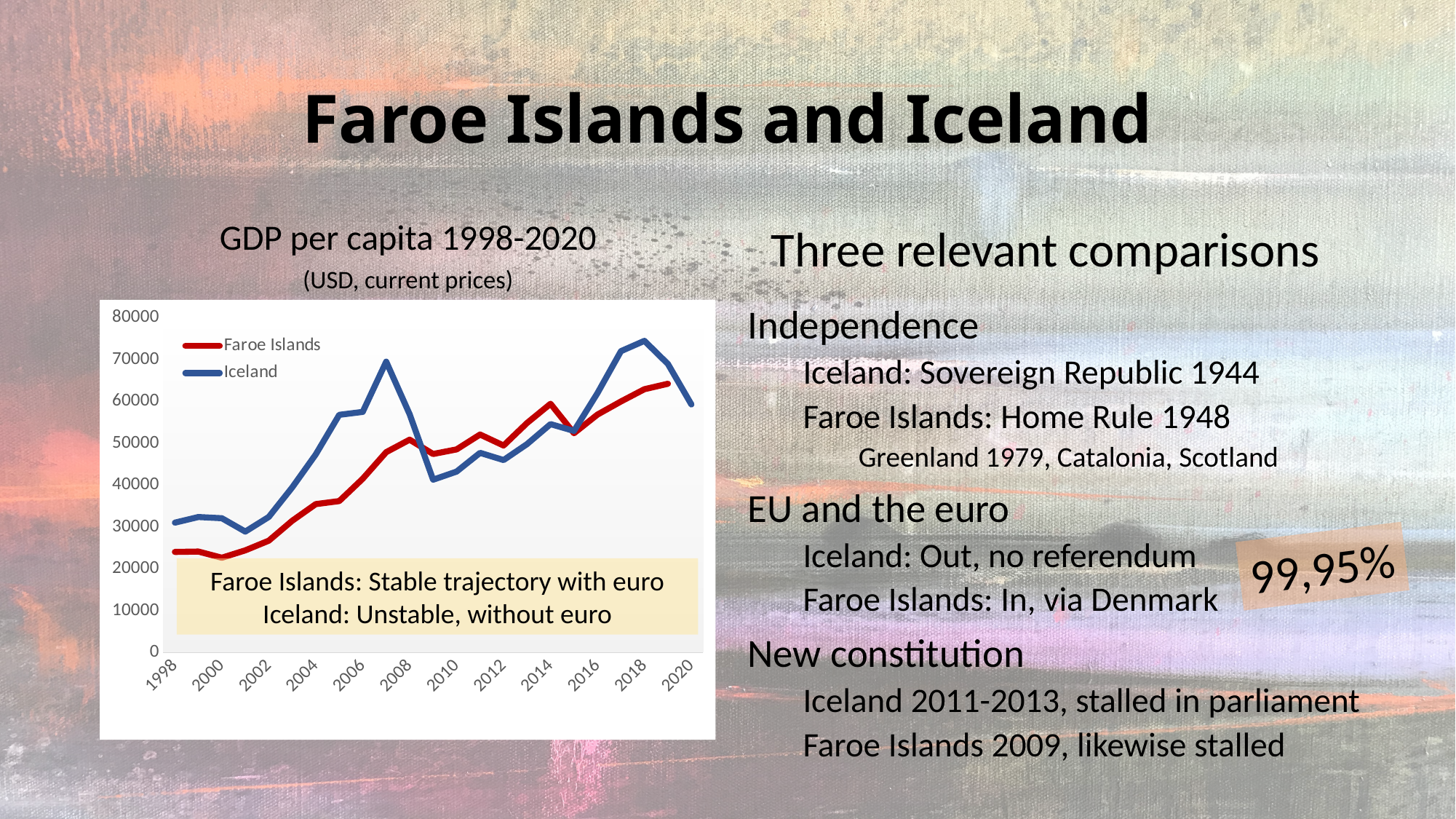
Which colour is used for the Iceland line in the chart? blue In 2007, which series has the larger value, Faroe Islands or Iceland? Iceland How many series does the chart's legend list? 2 In which year does the Iceland line reach its peak? 2018 What is the title of the chart? GDP per capita 1998-2020 Is the value for Faroe Islands in 2004 greater or less than 40000? less Is the value for Faroe Islands in 1998 greater or less than 30000? less What kind of chart is shown on the slide? line chart Is the value for Iceland in 2007 greater or less than 60000? greater In 2014, which series has the larger value, Faroe Islands or Iceland? Faroe Islands Which series reaches the highest value anywhere on the chart? Iceland